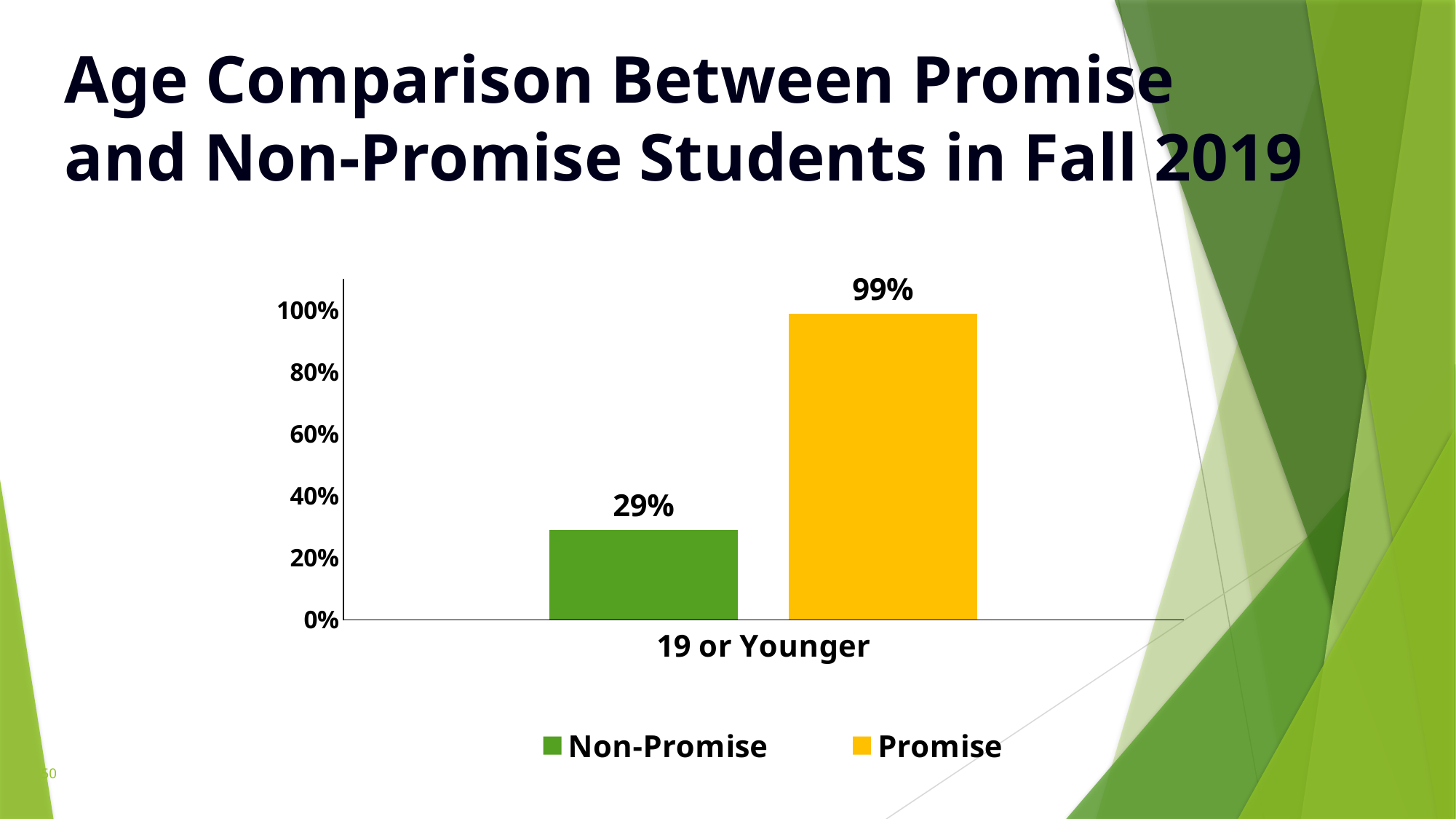
How many categories are shown on the x axis? 1 How many series does the legend list? 2 What is the difference between the Promise and Non-Promise values for 19 or Younger? 70% Which series has the higher value for 19 or Younger? Promise Is the Promise value for 19 or Younger greater or less than 80%? greater What colour is the Promise bar? Yellow What percentage of Promise students are 19 or younger? 99% What kind of chart is shown on the slide? Bar chart What is the category label on the x axis? 19 or Younger What percentage of Non-Promise students are 19 or younger? 29% Is the Non-Promise value for 19 or Younger greater or less than 40%? less Which series has the lower value for 19 or Younger? Non-Promise